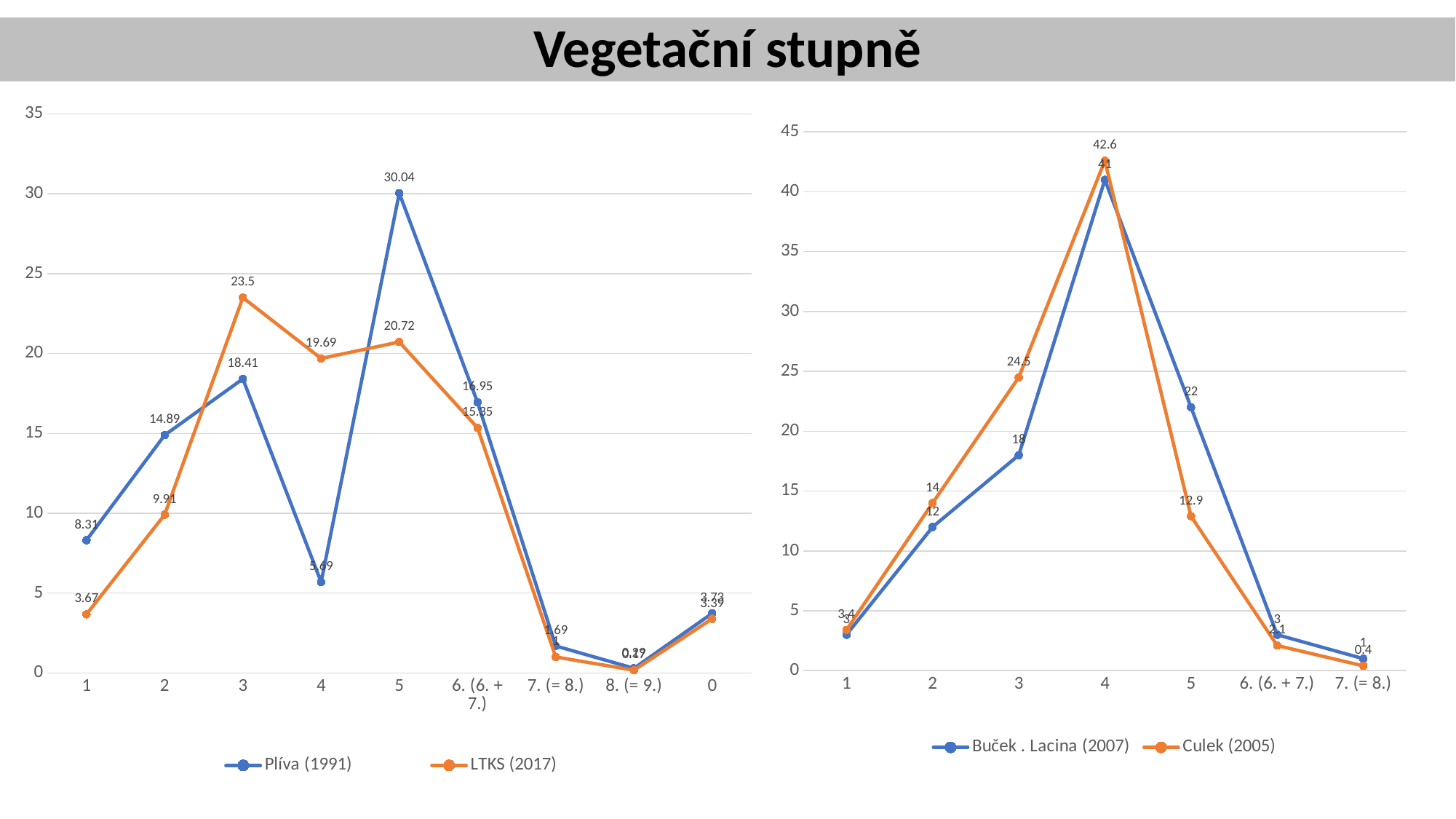
On the right chart, what is the value for Buček . Lacina (2007) at category 5? 22 On the left chart, what is the difference between Plíva (1991) and LTKS (2017) at category 4? 14 On the left chart, which series has the larger value at category 2, Plíva (1991) or LTKS (2017)? Plíva (1991) On the right chart, what is the value for Culek (2005) at category 4? 42.6 On the right chart, what is the difference between Buček . Lacina (2007) and Culek (2005) at category 5? 9.1 On the right chart, how many categories are shown on the x axis? 7 On the left chart, what is the value for LTKS (2017) at category 3? 23.5 On the left chart, what is the value for Plíva (1991) at category 5? 30.04 On the left chart, how many series does the legend list? 2 What kind of chart is the right chart? Line chart On the left chart, which category has the highest value for Plíva (1991)? 5 On the right chart, which category has the highest value for Culek (2005)? 4